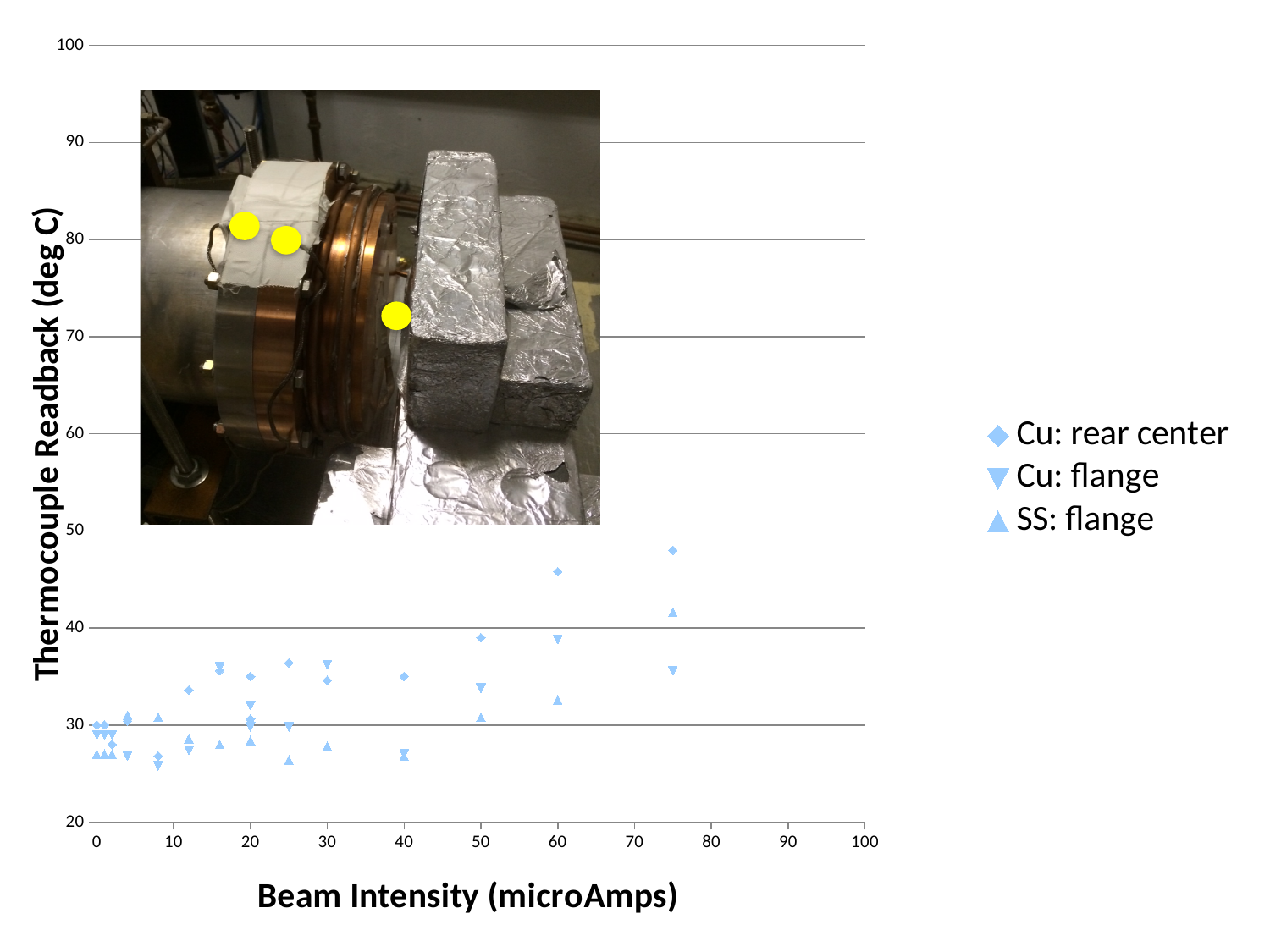
What is the title of the x axis? Beam Intensity (microAmps) Is the Cu: rear center value at 60 microAmps greater or less than 40? greater Is the Cu: flange value at 75 microAmps greater or less than 40? less Is the Cu: rear center value at 75 microAmps greater or less than 40? greater What is the title of the y axis? Thermocouple Readback (deg C) At 75 microAmps, which series has the higher thermocouple readback, Cu: rear center or Cu: flange? Cu: rear center Which series reaches the highest thermocouple readback on the chart? Cu: rear center What kind of chart is shown on the slide? scatter chart At 60 microAmps, which series has the higher thermocouple readback, Cu: rear center or SS: flange? Cu: rear center How many series does the legend list? 3 Does the Cu: rear center thermocouple readback generally rise or fall as beam intensity increases? rise